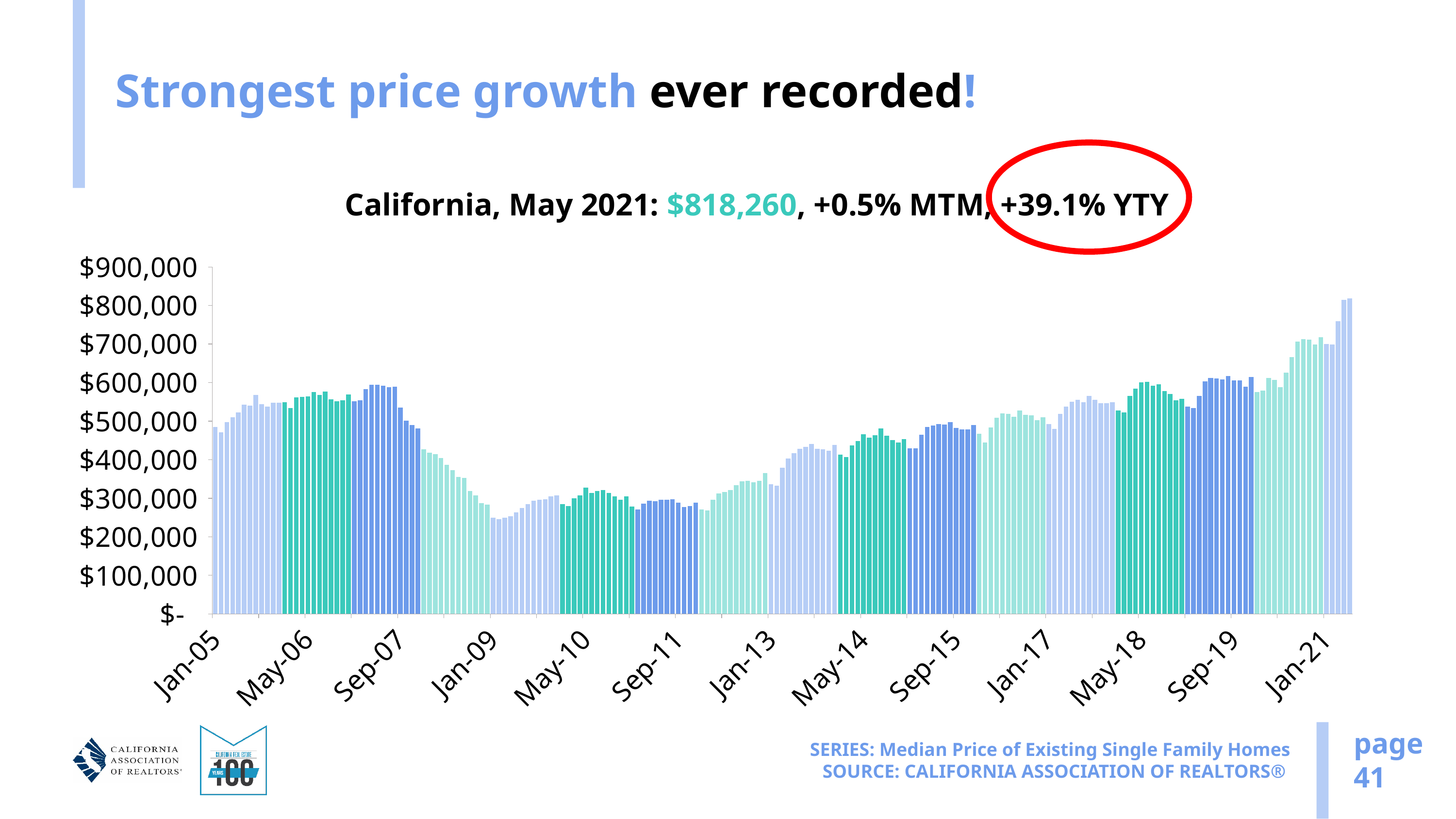
Is the value for Jan-13 greater or less than $400,000? less What is the year-to-year (YTY) change shown for California in May 2021? +39.1% Do the values rise or fall between Sep-07 and Jan-09? fall What is the median price for California in May 2021 according to the chart subtitle? $818,260 Is the value for Jan-09 greater or less than $300,000? less Is the value for Sep-07 greater or less than $500,000? greater What kind of chart is shown on the slide? bar chart What is the month-to-month (MTM) change shown for California in May 2021? +0.5% Which month has the highest median price on the chart? May 2021 What series does the chart plot, according to the note at the bottom of the slide? Median Price of Existing Single Family Homes Which is larger, the value for Sep-07 or the value for Jan-09? Sep-07